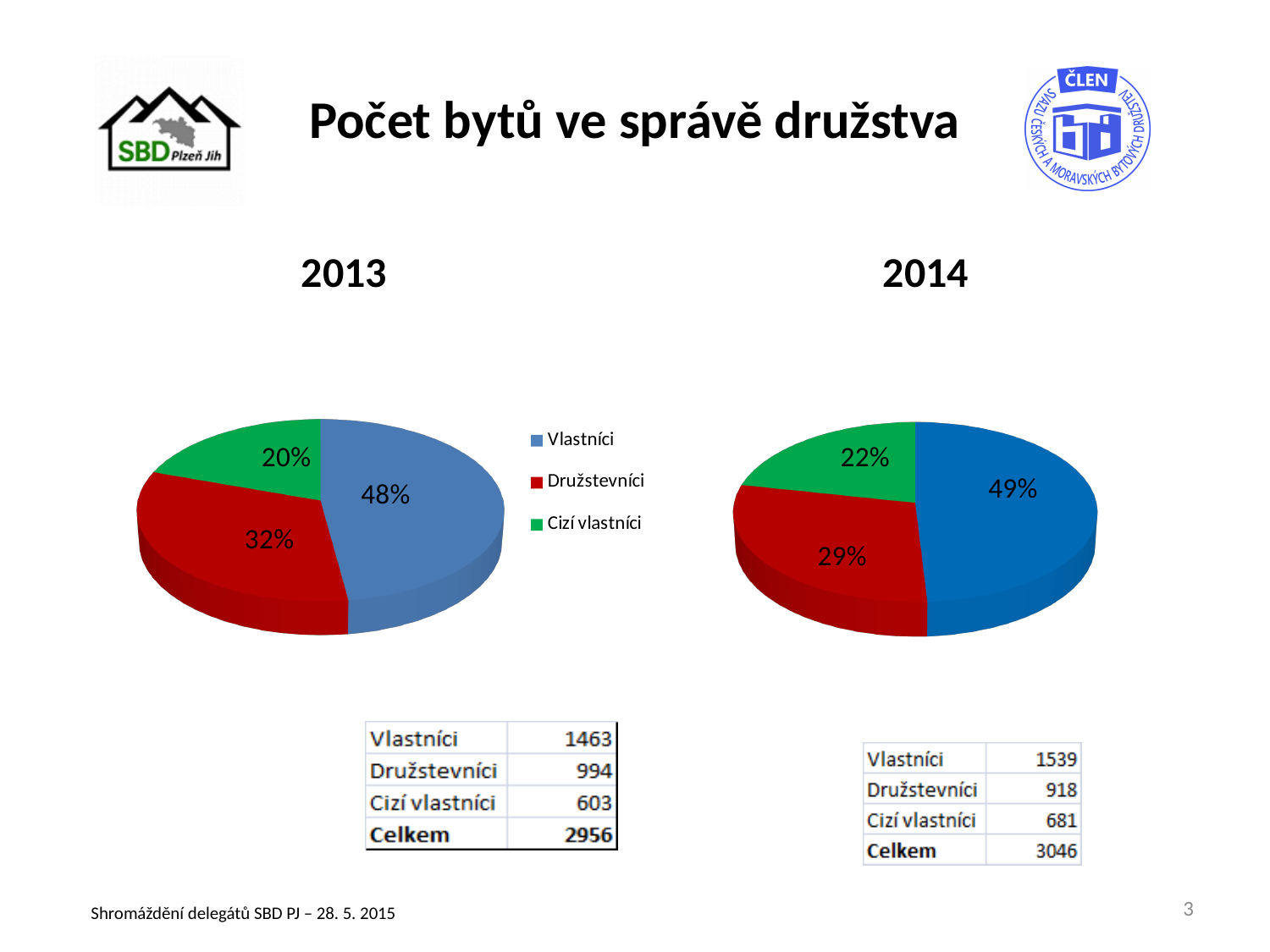
In the 2014 pie chart, which category has the smallest slice? Cizí vlastníci In the 2013 pie chart, which category has the largest slice? Vlastníci In the 2013 pie chart, what share is labelled for Cizí vlastníci? 20% What kind of chart is used for the 2013 data? pie chart In the 2014 pie chart, what share is labelled for Vlastníci? 49% How many entries does the legend list? 3 In the 2014 pie chart, what share is labelled for Družstevníci? 29% How many slices does the 2013 pie chart have? 3 In the 2013 pie chart, what is the difference in percentage points between the Vlastníci slice and the Družstevníci slice? 16